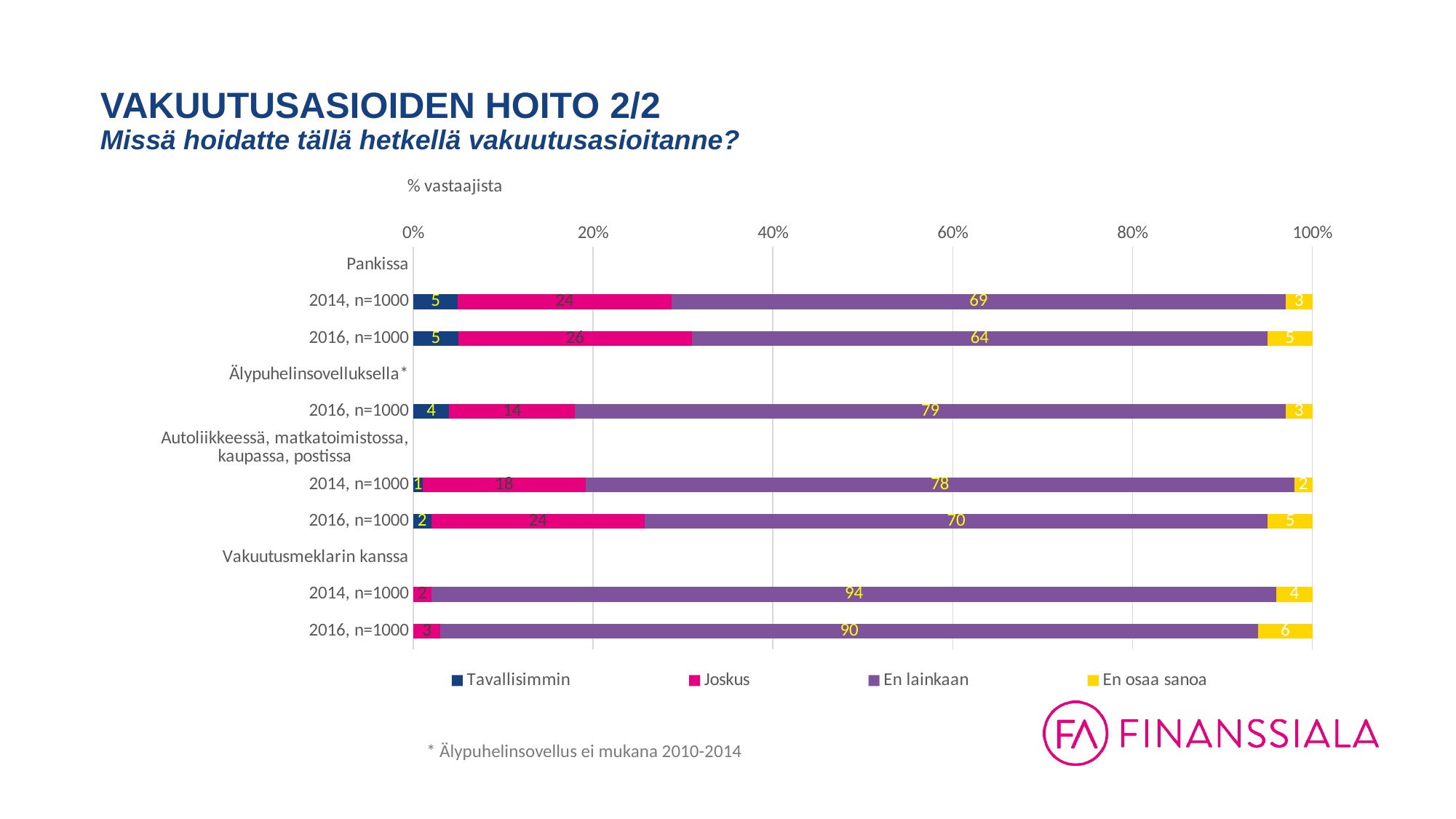
What is the total of the stacked bar for Älypuhelinsovelluksella, 2016, n=1000? 100 Which is larger: the 'Joskus' value for Autoliikkeessä, matkatoimistossa, kaupassa, postissa in 2014 or in 2016? 2016 What is the difference between the 'En lainkaan' values for Pankissa in 2014 and 2016? 5 Which bar has the highest 'En lainkaan' value? Vakuutusmeklarin kanssa, 2014, n=1000 What is the 'En lainkaan' value for Älypuhelinsovelluksella, 2016, n=1000? 79 What is the 'Joskus' value for Pankissa, 2016, n=1000? 26 Which bar has the lowest 'Joskus' value? Vakuutusmeklarin kanssa, 2014, n=1000 What is the 'En osaa sanoa' value for Vakuutusmeklarin kanssa, 2016, n=1000? 6 How many bars are plotted in the chart? 7 What is the 'En lainkaan' value for Pankissa, 2014, n=1000? 69 What kind of chart is shown on the slide? Stacked bar chart How many series does the legend list? 4